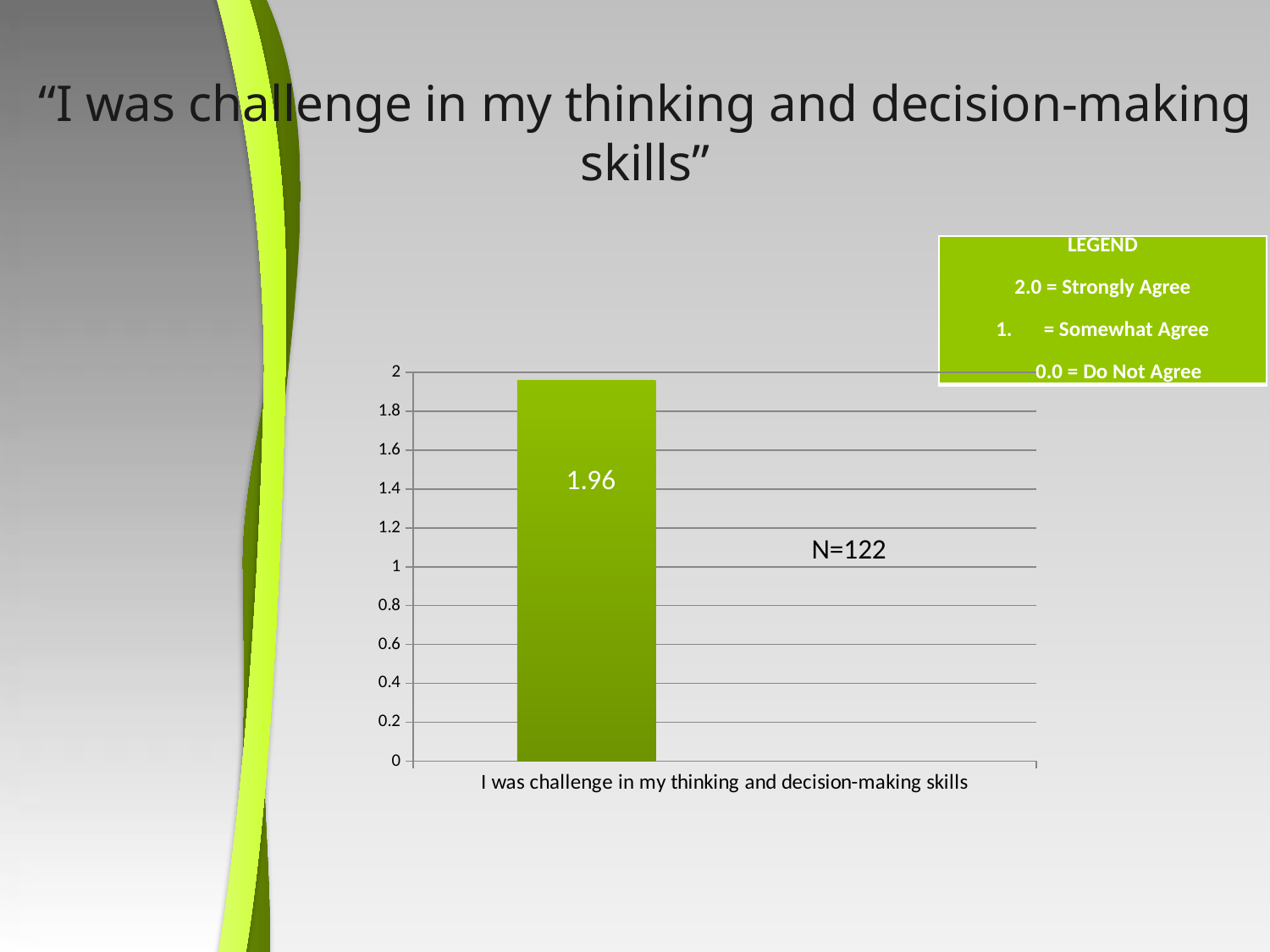
What sample size (N) is shown on the chart? N=122 What kind of chart is shown on the slide? bar chart How many bars does the chart show? 1 What is the maximum value shown on the vertical axis? 2 What is the value shown for "I was challenge in my thinking and decision-making skills"? 1.96 What is the category label on the x axis of the chart? I was challenge in my thinking and decision-making skills Is the value for "I was challenge in my thinking and decision-making skills" greater or less than 1? greater Is the value for "I was challenge in my thinking and decision-making skills" greater or less than 1.8? greater